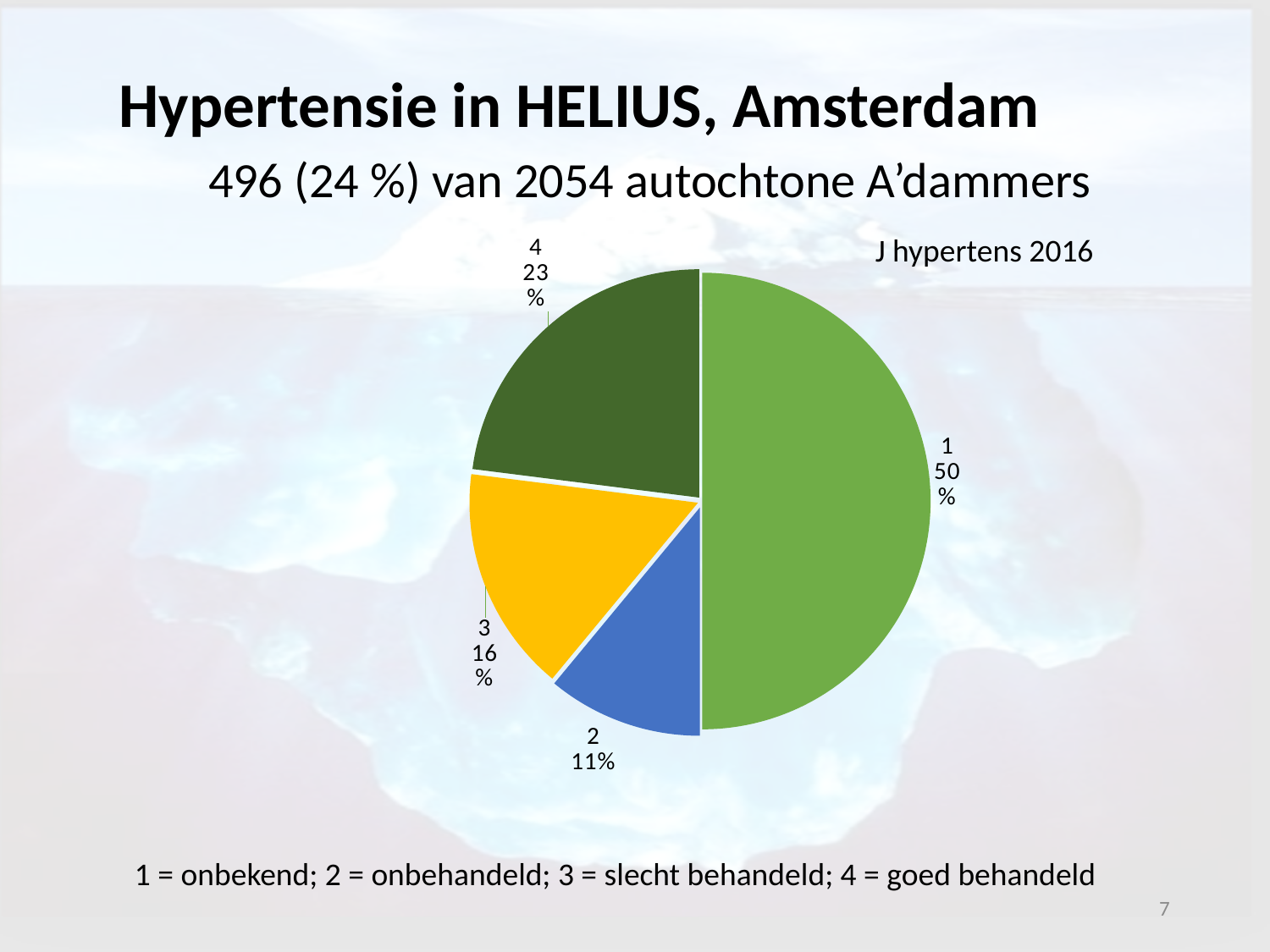
What share of the pie does category 1 (onbekend) have? 50% What share of the pie does category 3 (slecht behandeld) have? 16% According to the slide's legend text, what does category 4 stand for? goed behandeld Which is larger, the slice for category 3 or the slice for category 2? 3 What is the difference in percentage points between category 4 and category 3? 7 What is the difference in percentage points between category 1 and category 4? 27 What kind of chart is shown on the slide? pie chart Which category has the largest slice of the pie? 1 What share of the pie does category 4 (goed behandeld) have? 23% How many slices does the pie chart have? 4 Which category has the smallest slice of the pie? 2